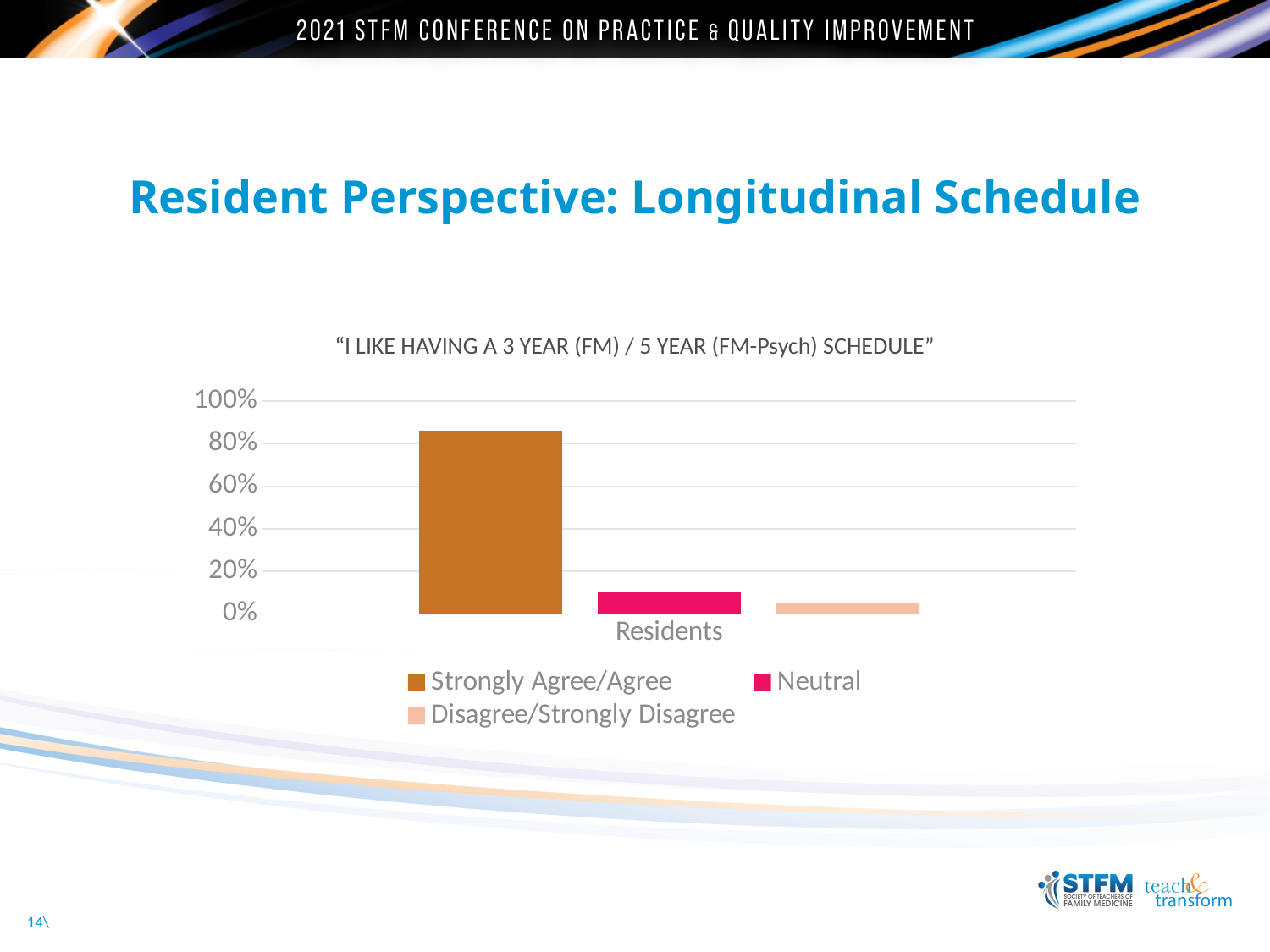
Is the value for Neutral greater or less than 20%? less Which series has the highest value for Residents? Strongly Agree/Agree How many categories are shown on the x axis of the chart? 1 What kind of chart is shown on the slide? bar chart Is the value for Disagree/Strongly Disagree greater or less than 20%? less Which is larger for Residents: Neutral or Disagree/Strongly Disagree? Neutral Which is larger for Residents: Strongly Agree/Agree or Neutral? Strongly Agree/Agree What is the label of the category on the x axis? Residents What is the title of the chart? "I LIKE HAVING A 3 YEAR (FM) / 5 YEAR (FM-Psych) SCHEDULE" How many series does the chart legend list? 3 Which series has the lowest value for Residents? Disagree/Strongly Disagree Is the value for Strongly Agree/Agree greater or less than 60%? greater